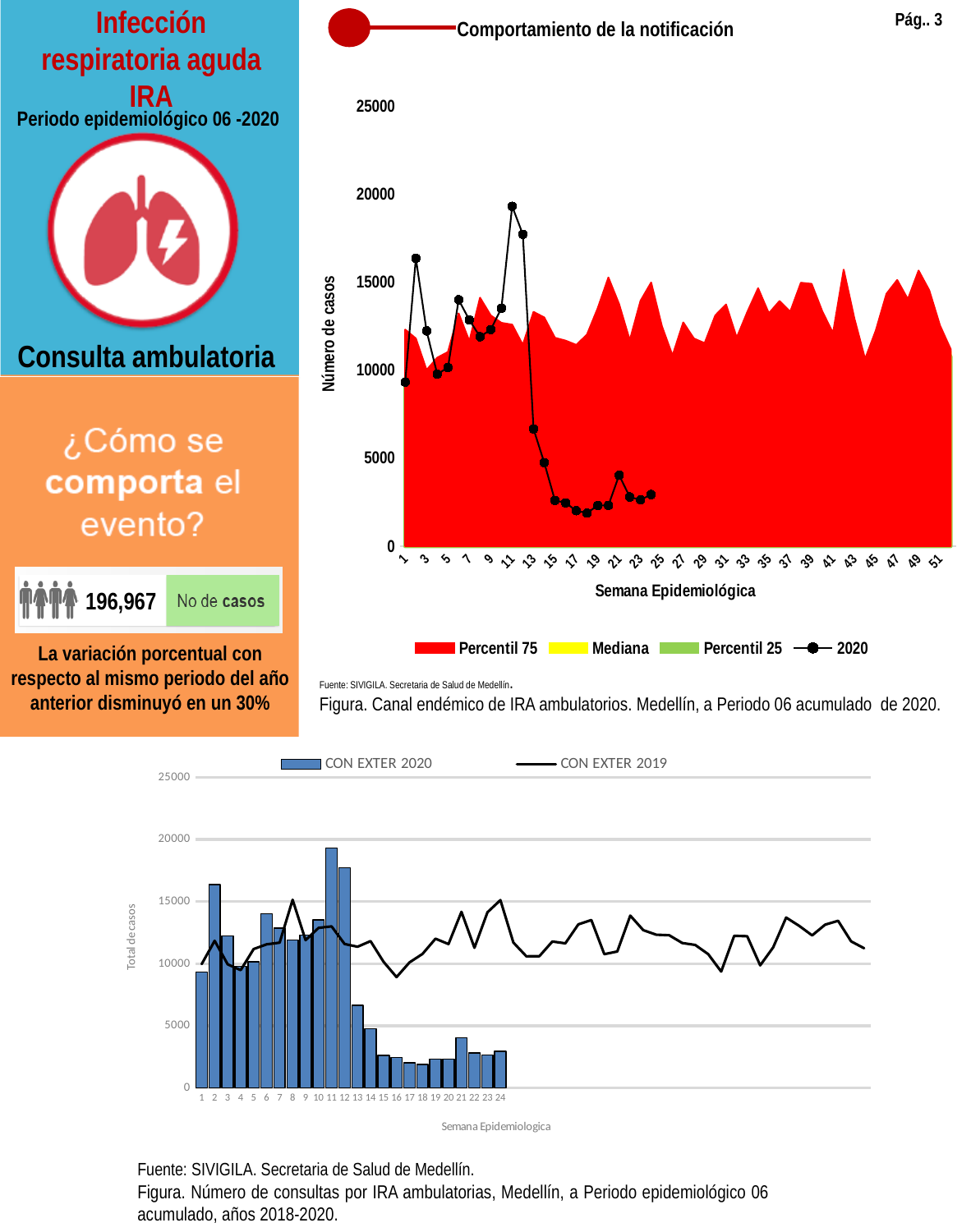
In the bottom chart, which week has the highest CON EXTER 2020 bar? 11 In the top chart 'Comportamiento de la notificación', what is the label of the y axis? Número de casos In the bottom chart, how many bars are plotted for CON EXTER 2020? 24 In the bottom chart, what kind of chart is used for the CON EXTER 2020 series? bar chart In the bottom chart, do the CON EXTER 2020 bars rise or fall from week 12 to week 17? fall In the top chart 'Comportamiento de la notificación', is the 2020 value at week 15 greater or less than 5000? less In the top chart 'Comportamiento de la notificación', how many series does the legend list? 4 In the top chart 'Comportamiento de la notificación', at which epidemiological week does the 2020 line reach its highest value? 11 In the top chart 'Comportamiento de la notificación', is the 2020 value at week 11 greater or less than 15000? greater In the top chart 'Comportamiento de la notificación', which is larger for 2020: the value at week 12 or the value at week 14? week 12 In the top chart 'Comportamiento de la notificación', is the 2020 value at week 2 greater or less than 15000? greater